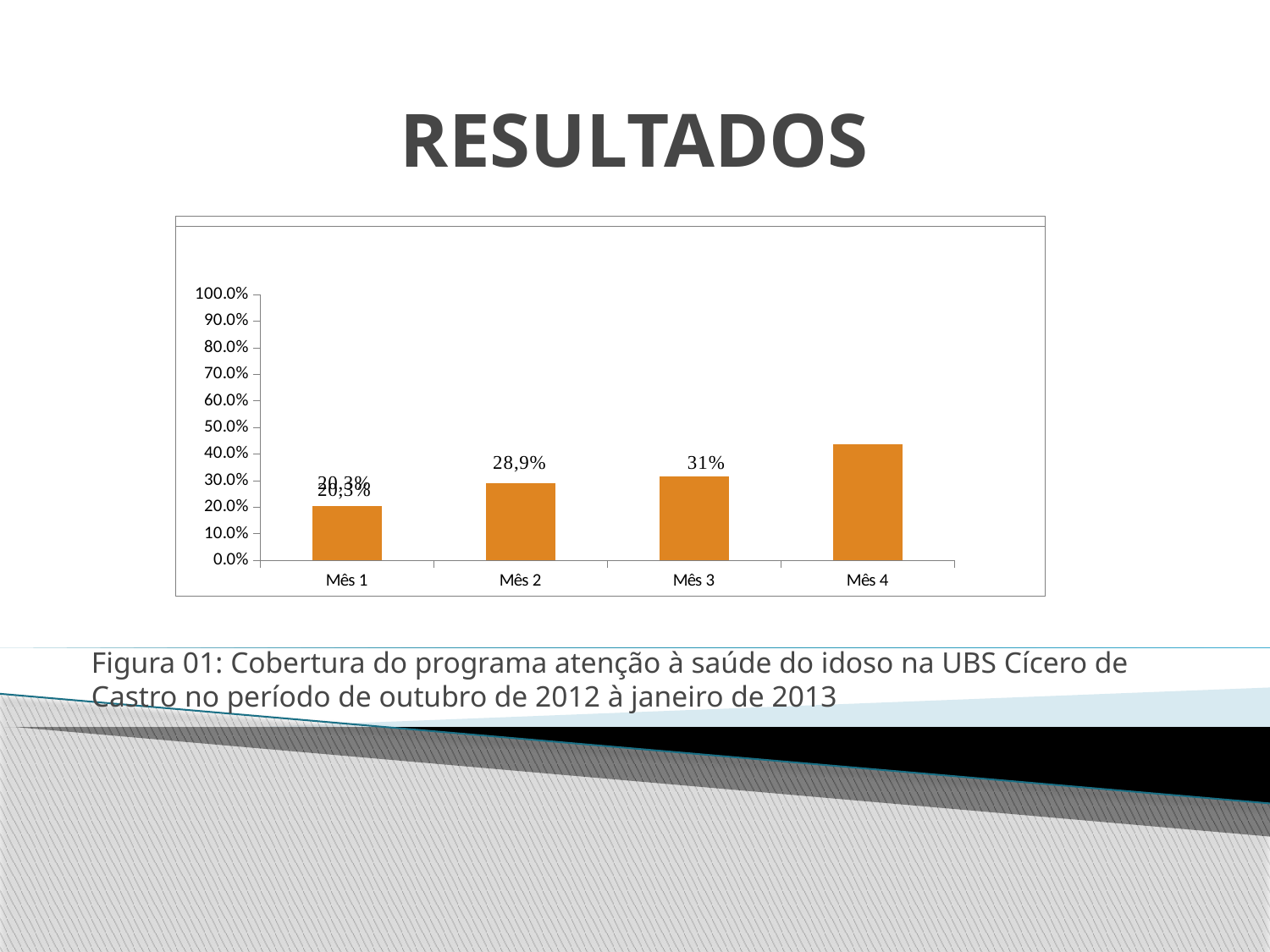
Is the value for Mês 4 greater or less than 40%? greater What is the difference between the values for Mês 3 and Mês 2? 2,1% Is the value for Mês 1 greater or less than 30%? less Which month has the highest bar? Mês 4 Is the value for Mês 4 greater or less than 50%? less Do the values rise or fall from Mês 1 to Mês 4? rise What kind of chart is shown on the slide? bar chart What colour are the bars in the chart? orange How many months (categories) are plotted on the chart? 4 What is the value shown for Mês 3? 31% Which month has the lowest bar? Mês 1 What is the value shown for Mês 2? 28,9%